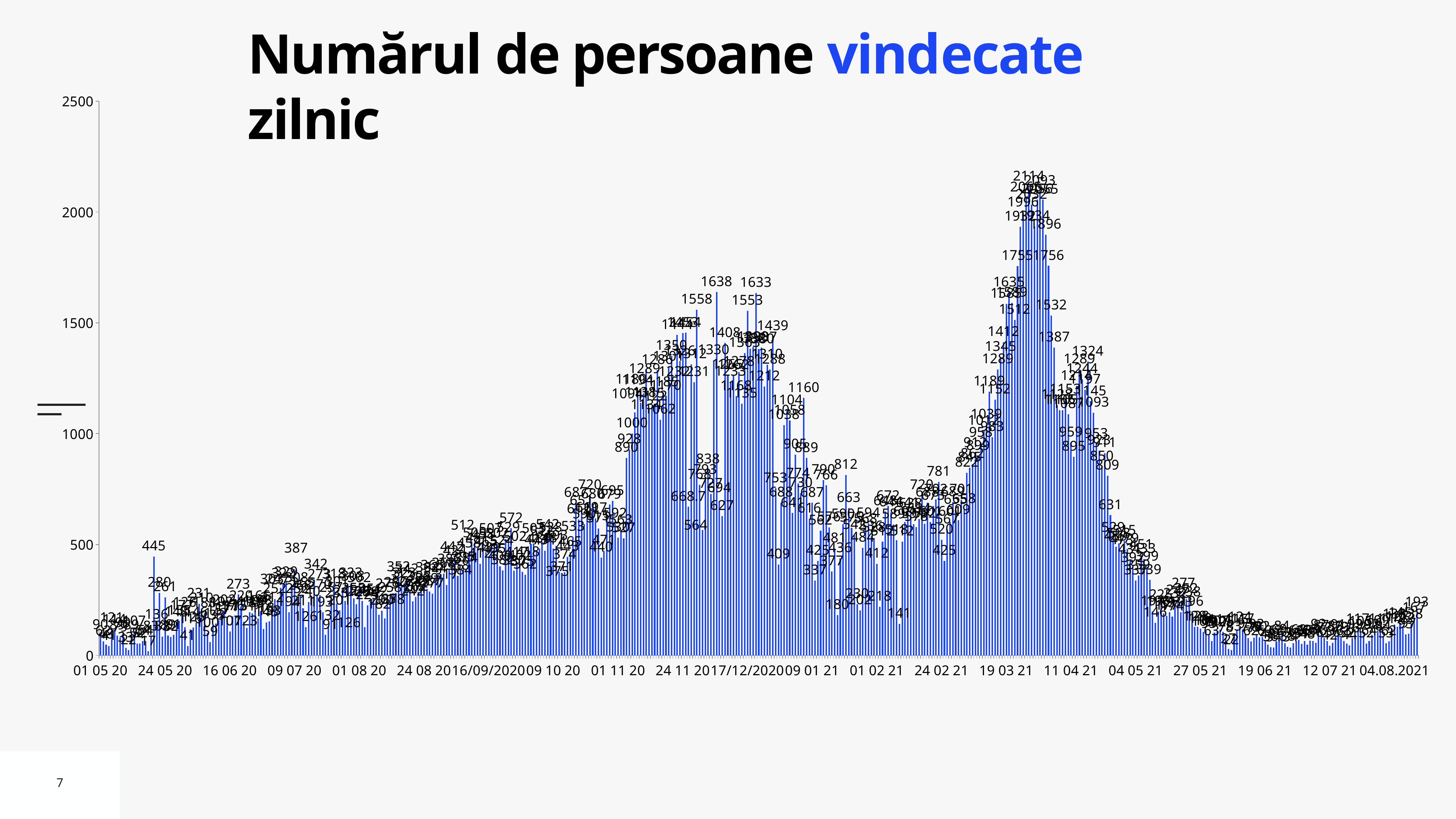
What is the last date label on the horizontal axis? 04.08.2021 Is the value at the 19 03 21 tick greater or less than 1000? greater Do the values rise or fall between 11 04 21 and 04 05 21? fall Is the value for the last bar (04.08.2021) greater or less than 500? less What kind of chart is shown on the slide? bar chart Is the value at the 19 06 21 tick greater or less than 500? less What is the highest value shown on the vertical axis? 2500 How many date labels are shown on the horizontal axis? 21 Which wave has the taller peak: the one around 24 11 20 or the one between 19 03 21 and 11 04 21? the one between 19 03 21 and 11 04 21 What is the title of the chart? Numărul de persoane vindecate zilnic What is the first date label on the horizontal axis? 01 05 20 What is the highest value labelled on the chart? 2114